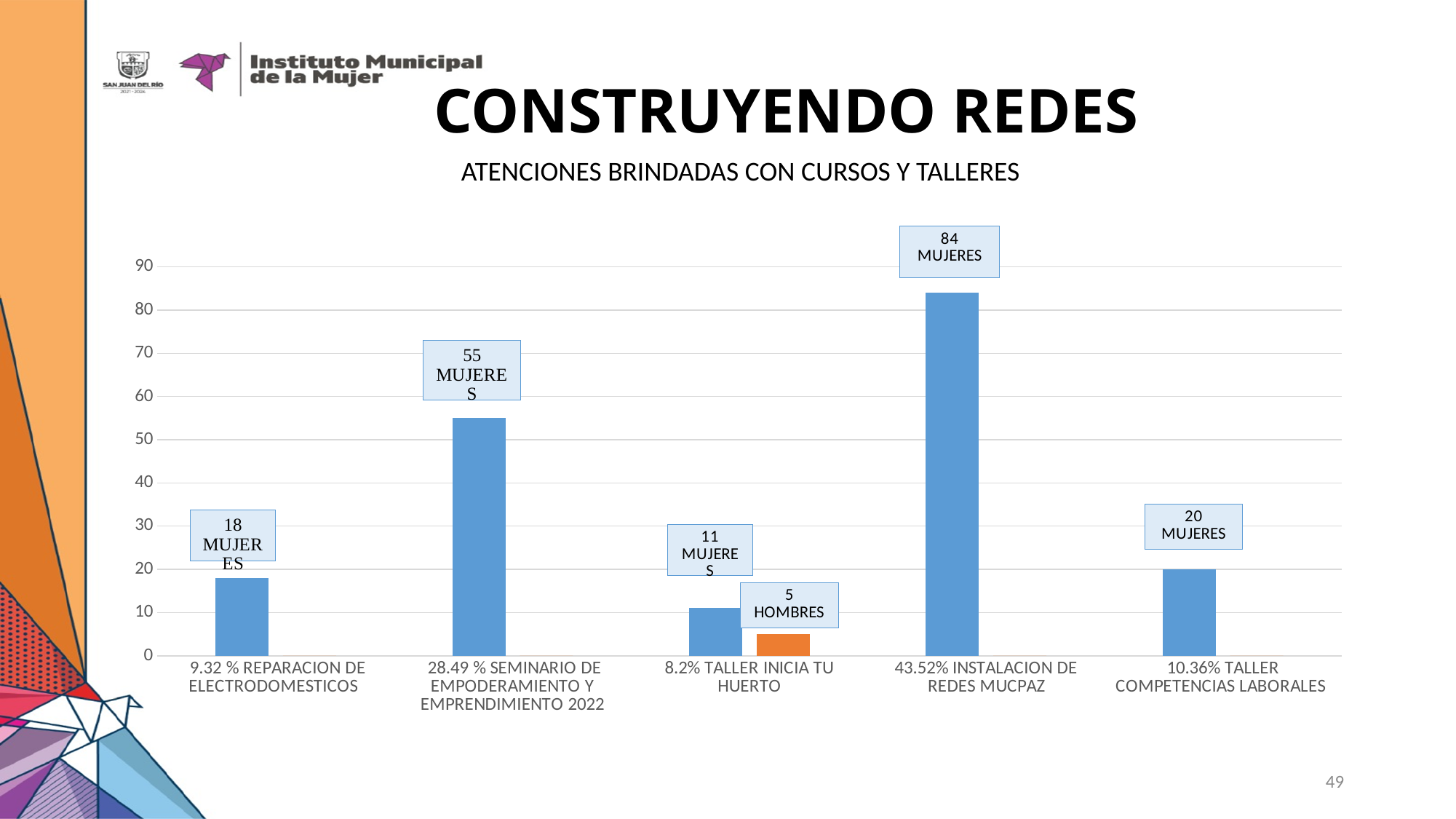
What is the difference between the number of mujeres for 43.52% INSTALACION DE REDES MUCPAZ and for 28.49 % SEMINARIO DE EMPODERAMIENTO Y EMPRENDIMIENTO 2022? 29 How many mujeres are shown for 43.52% INSTALACION DE REDES MUCPAZ? 84 How many mujeres are shown for 10.36% TALLER COMPETENCIAS LABORALES? 20 Which category has the lowest number of mujeres? 8.2% TALLER INICIA TU HUERTO What is the total number of mujeres and hombres for 8.2% TALLER INICIA TU HUERTO? 16 Which has more mujeres: 9.32 % REPARACION DE ELECTRODOMESTICOS or 10.36% TALLER COMPETENCIAS LABORALES? 10.36% TALLER COMPETENCIAS LABORALES How many mujeres are shown for 28.49 % SEMINARIO DE EMPODERAMIENTO Y EMPRENDIMIENTO 2022? 55 Which category has the highest number of mujeres? 43.52% INSTALACION DE REDES MUCPAZ How many hombres are shown for 8.2% TALLER INICIA TU HUERTO? 5 What is the title of the chart? ATENCIONES BRINDADAS CON CURSOS Y TALLERES How many categories are shown on the x axis of the chart? 5 What type of chart is shown on the slide? Bar chart